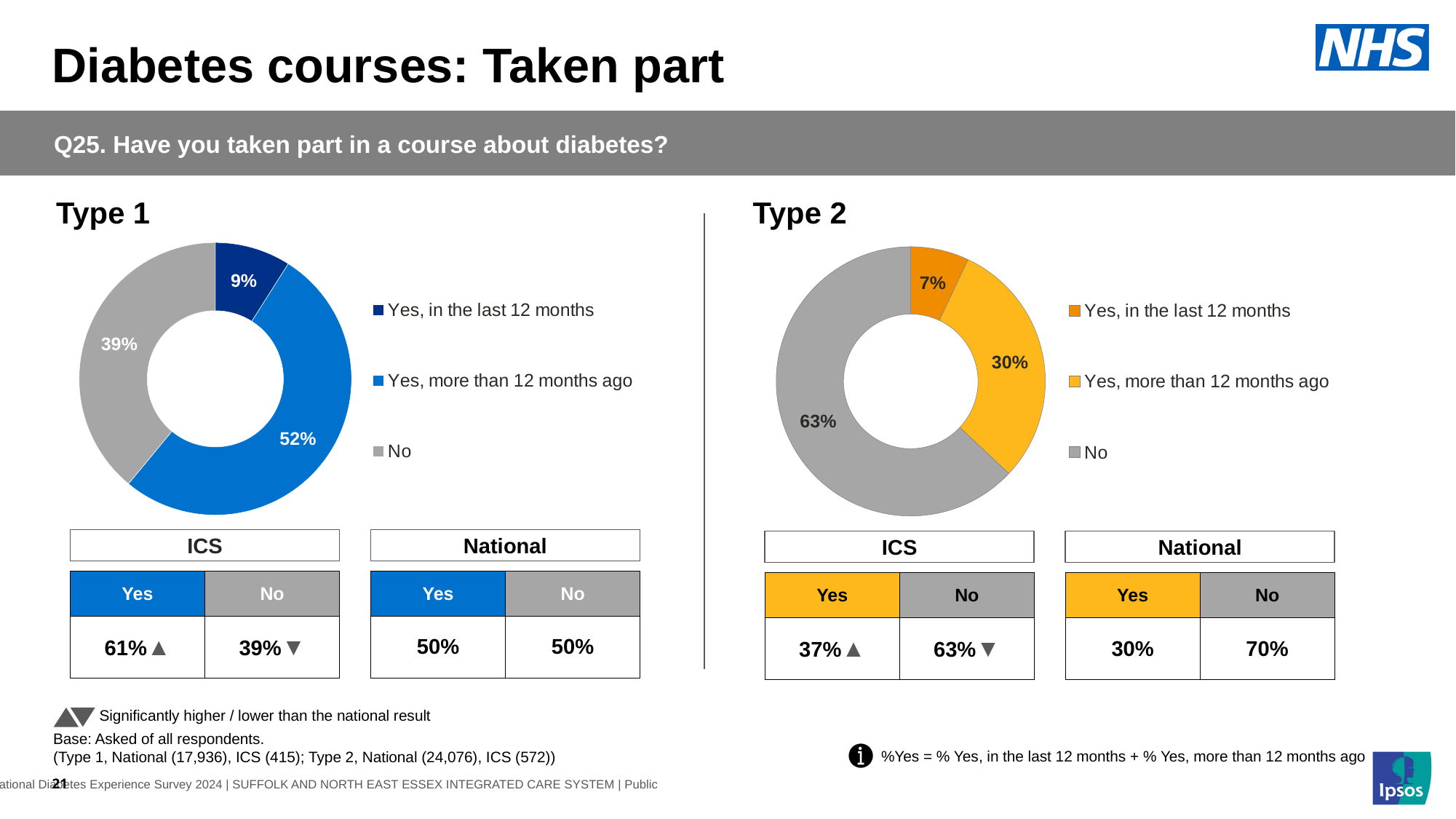
In the Type 1 chart, what percentage of respondents answered 'Yes, more than 12 months ago'? 52% Which is larger: the 'No' share in the Type 1 chart or the 'No' share in the Type 2 chart? Type 2 In the Type 2 chart, what is the difference between the 'No' share and the 'Yes, more than 12 months ago' share? 33 percentage points What colour represents 'Yes, in the last 12 months' in the Type 2 chart? Orange In the Type 1 chart, what is the difference between the 'No' share and the 'Yes, in the last 12 months' share? 30 percentage points How many categories does the Type 1 chart show? 3 In the Type 2 chart, what percentage of respondents answered 'Yes, more than 12 months ago'? 30% In the Type 2 chart, which category has the smallest share? Yes, in the last 12 months In the Type 1 chart, what percentage of respondents answered 'Yes, in the last 12 months'? 9% In the Type 1 chart, which category has the largest share? Yes, more than 12 months ago In the Type 2 chart, what percentage of respondents answered 'No'? 63% What kind of chart is used for Type 2? Doughnut chart